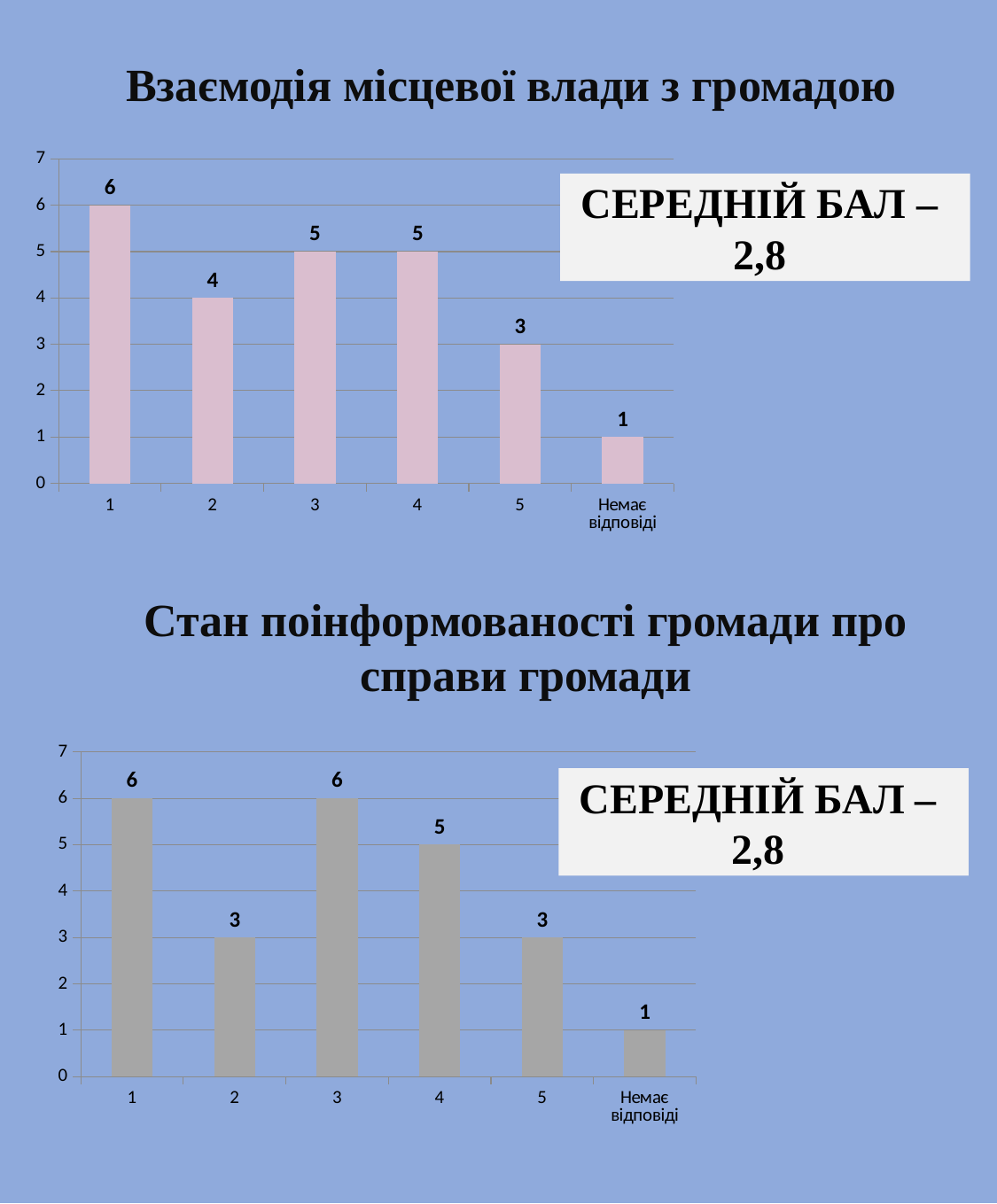
In the bottom chart 'Стан поінформованості громади про справи громади', what is the value for category 2? 3 In the top chart 'Взаємодія місцевої влади з громадою', which category has the highest value? 1 What average score (СЕРЕДНІЙ БАЛ) is shown in the box next to the top chart? 2,8 In the top chart 'Взаємодія місцевої влади з громадою', what is the value for category 'Немає відповіді'? 1 In the bottom chart 'Стан поінформованості громади про справи громади', what is the difference between the values for category 3 and category 5? 3 In the top chart 'Взаємодія місцевої влади з громадою', what is the difference between the values for category 1 and category 2? 2 In the top chart 'Взаємодія місцевої влади з громадою', how many categories are shown on the x axis? 6 In the bottom chart 'Стан поінформованості громади про справи громади', what is the value for category 4? 5 In the top chart 'Взаємодія місцевої влади з громадою', what is the value for category 1? 6 In the bottom chart 'Стан поінформованості громади про справи громади', which category has the lowest value? Немає відповіді What type of chart is the bottom chart 'Стан поінформованості громади про справи громади'? bar chart In the bottom chart 'Стан поінформованості громади про справи громади', which is larger, the value for category 4 or category 5? category 4